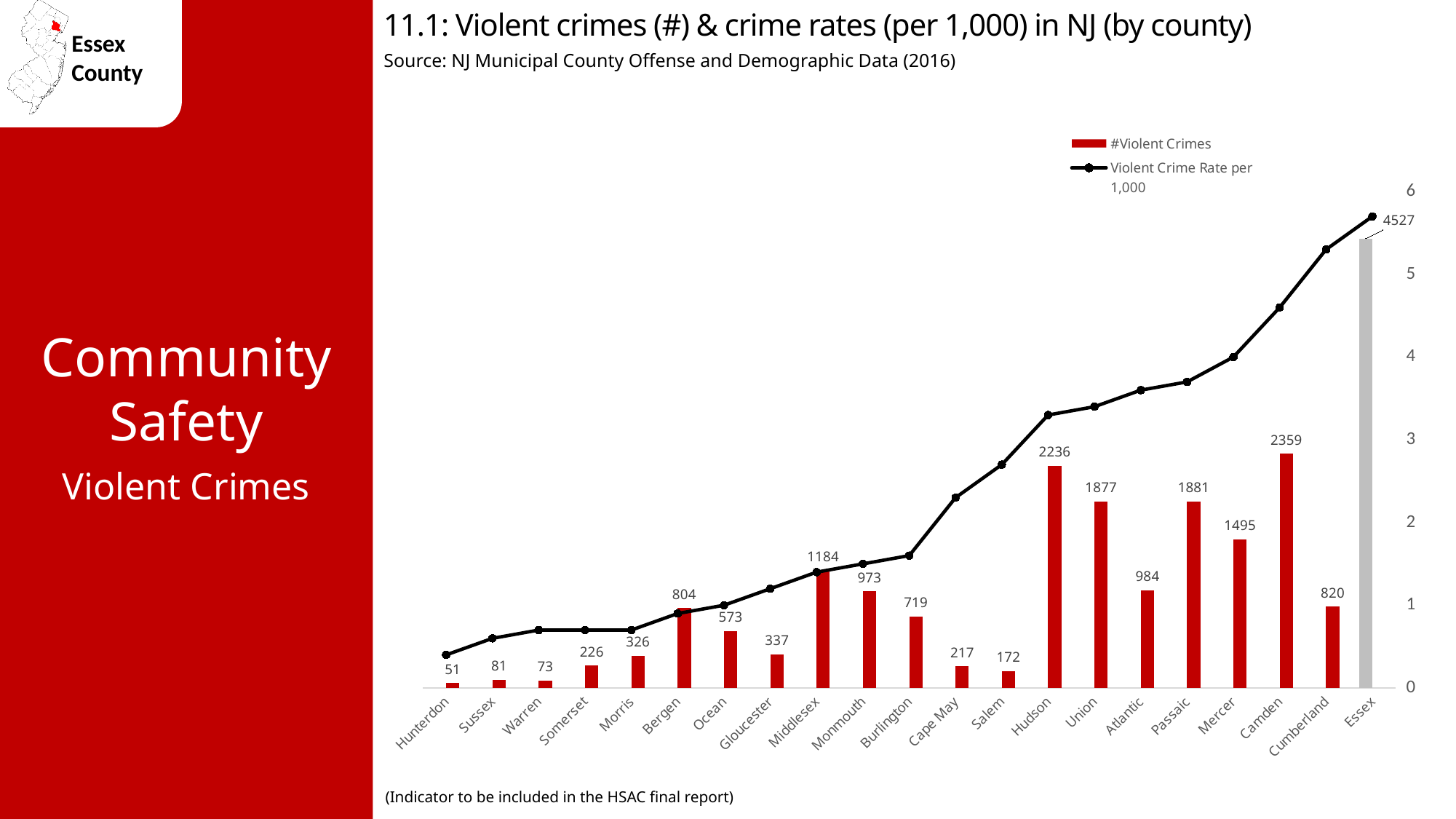
Which county has more violent crimes, Mercer or Atlantic? Mercer What is the number of violent crimes for Cumberland County? 820 How many series does the chart legend list? 2 How many counties are shown on the x axis of the chart? 21 Is the violent crime rate per 1,000 for Hunterdon greater or less than 1? less What is the number of violent crimes for Middlesex County? 1184 How many violent crimes are shown for Hudson County? 2236 Which county has the highest number of violent crimes? Essex Does the violent crime rate per 1,000 line generally rise or fall from left to right across the counties? rise Which county has the lowest number of violent crimes? Hunterdon Is the violent crime rate per 1,000 for Essex greater or less than 5? greater What is the difference in the number of violent crimes between Camden and Hudson? 123